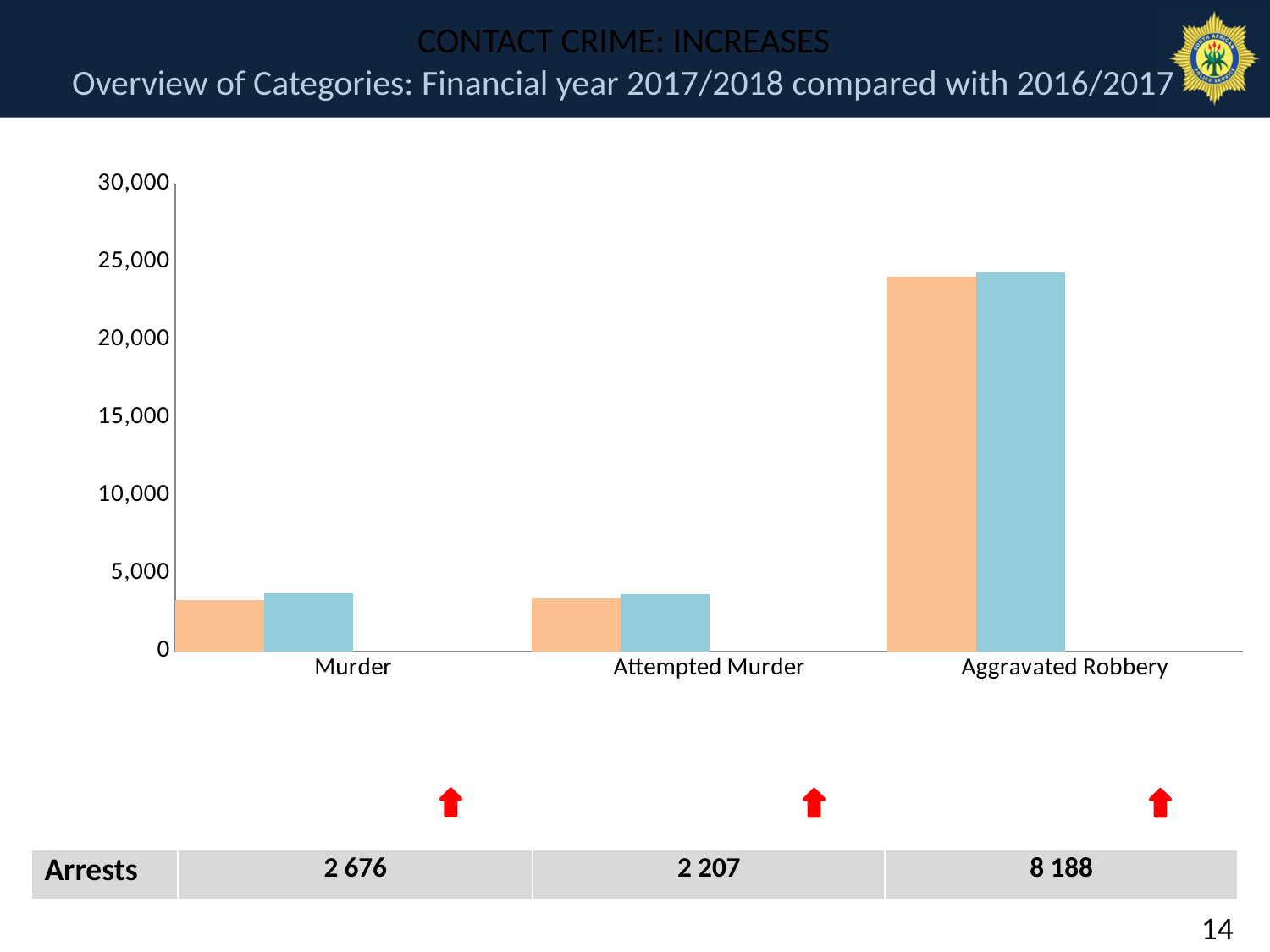
What is the highest value shown on the chart's vertical axis? 30,000 For Murder, is the blue (right-hand) bar taller or shorter than the orange (left-hand) bar? taller Which category has the highest bars in the chart? Aggravated Robbery Are the values for Aggravated Robbery greater or less than 20,000? greater Do the bar values rise or fall moving from Murder on the left to Aggravated Robbery on the right? rise How many crime categories are shown on the x axis of the chart? 3 What number of arrests is shown below the chart for Aggravated Robbery? 8 188 Are the values for Murder greater or less than 5,000? less What kind of chart is shown on the slide? bar chart Are the values for Aggravated Robbery greater or less than 25,000? less Which category has larger values, Murder or Aggravated Robbery? Aggravated Robbery